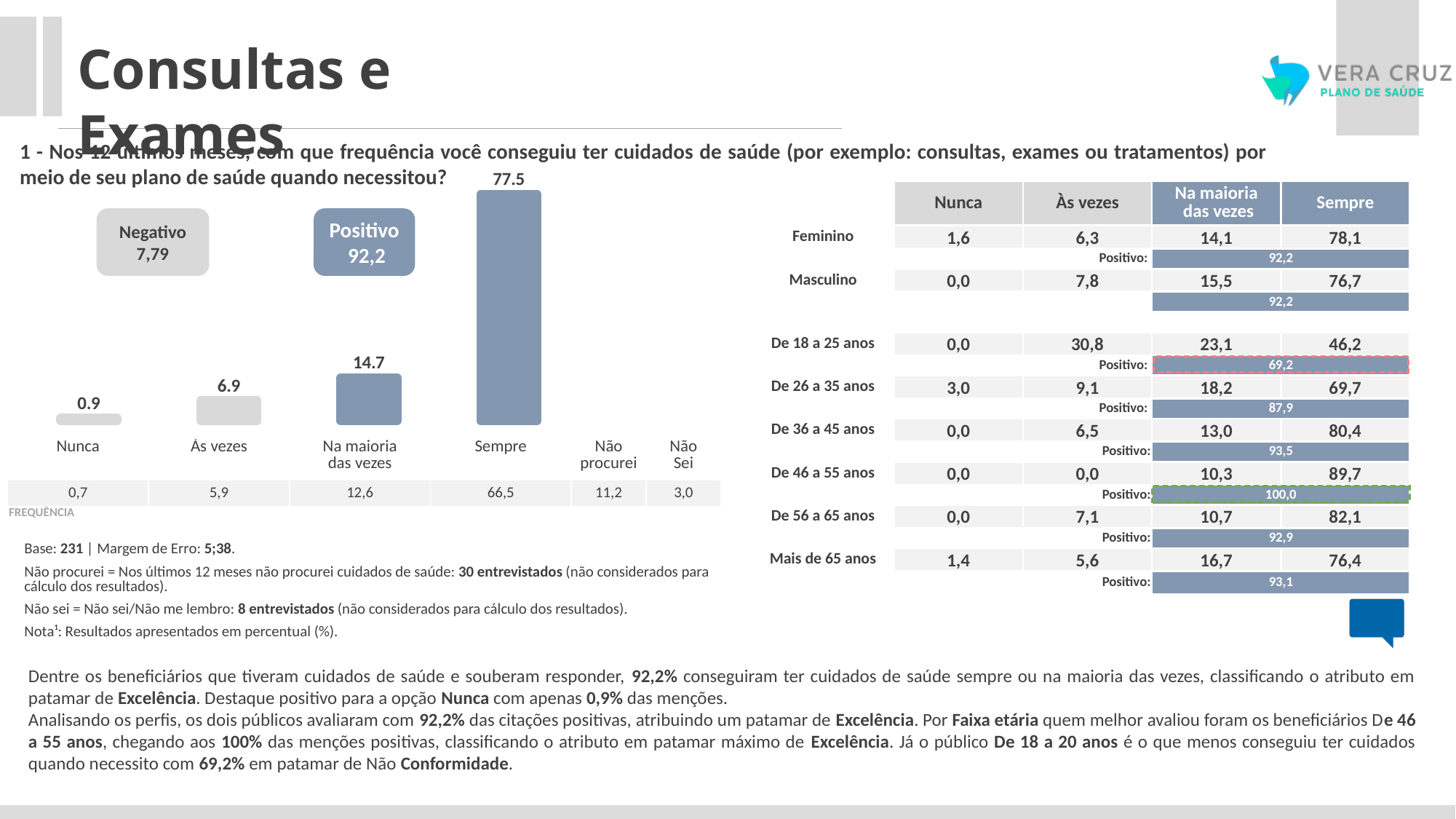
Which is larger, the value for Às vezes or the value for Na maioria das vezes? Na maioria das vezes What is the value for Sempre in the bar chart? 77.5 What value is shown in the Positivo box above the bar chart? 92,2 Which category has the lowest bar in the chart? Nunca What is the difference between the values for Às vezes and Nunca? 6.0 Which category has the highest bar in the chart? Sempre What is the difference between the values for Sempre and Na maioria das vezes? 62.8 Do the bar values rise or fall from Nunca to Sempre along the x axis? rise What is the value for Nunca in the bar chart? 0.9 What kind of chart is shown on the slide? bar chart What is the value for Às vezes in the bar chart? 6.9 What is the value for Na maioria das vezes in the bar chart? 14.7